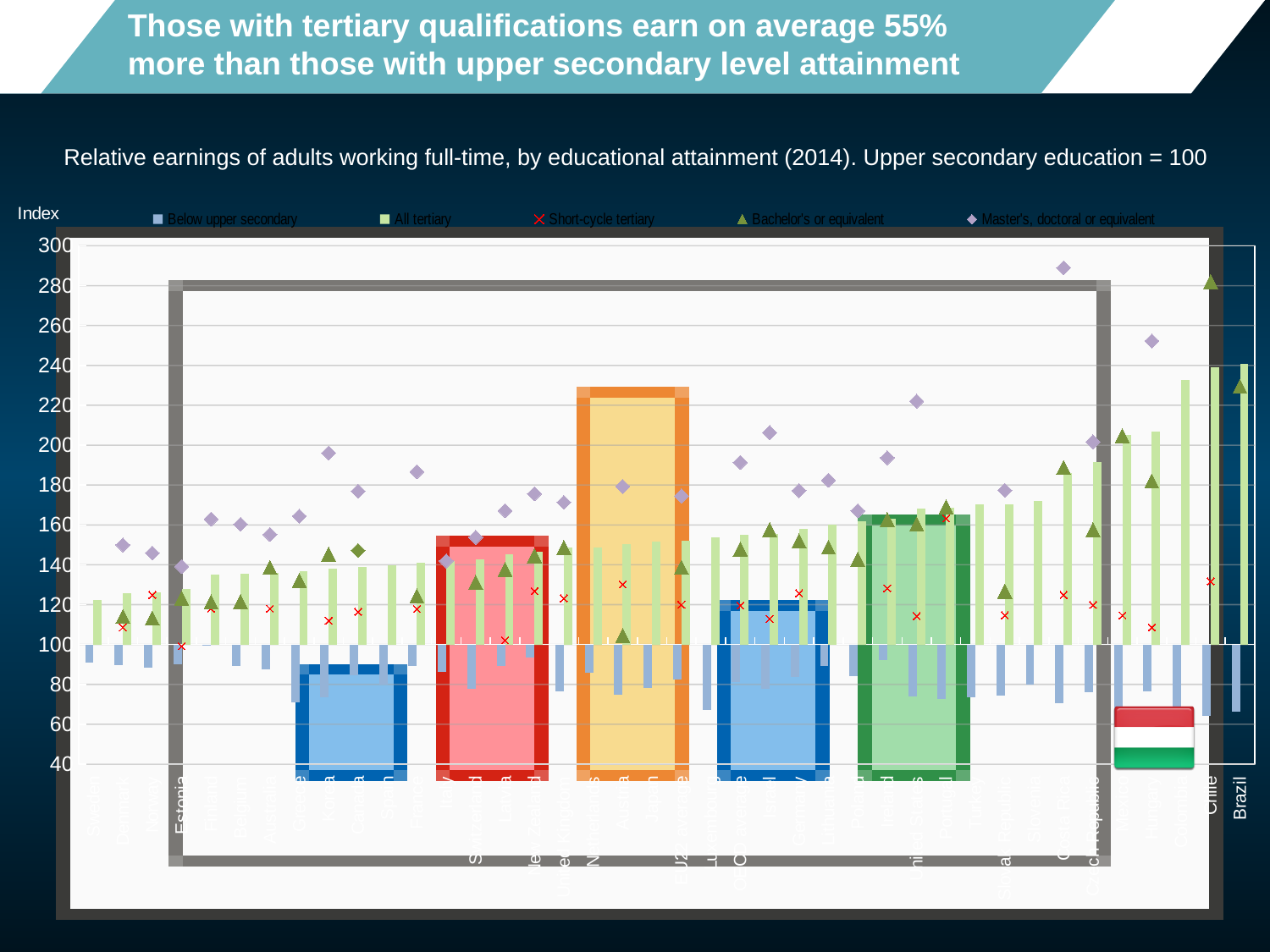
Is the Master's, doctoral or equivalent value for Estonia greater or less than 120? greater Is the All tertiary value for Brazil greater or less than 200? greater Which has the larger Bachelor's or equivalent value, Chile or Brazil? Chile What label is shown on the vertical axis of the chart? Index Is the Below upper secondary value for Chile greater or less than 80? less How many series does the chart's legend list? 5 What is the title of the chart? Relative earnings of adults working full-time, by educational attainment (2014). Upper secondary education = 100 Which has the larger All tertiary value, Estonia or Brazil? Brazil What kind of chart is shown on the slide? combination bar and line chart